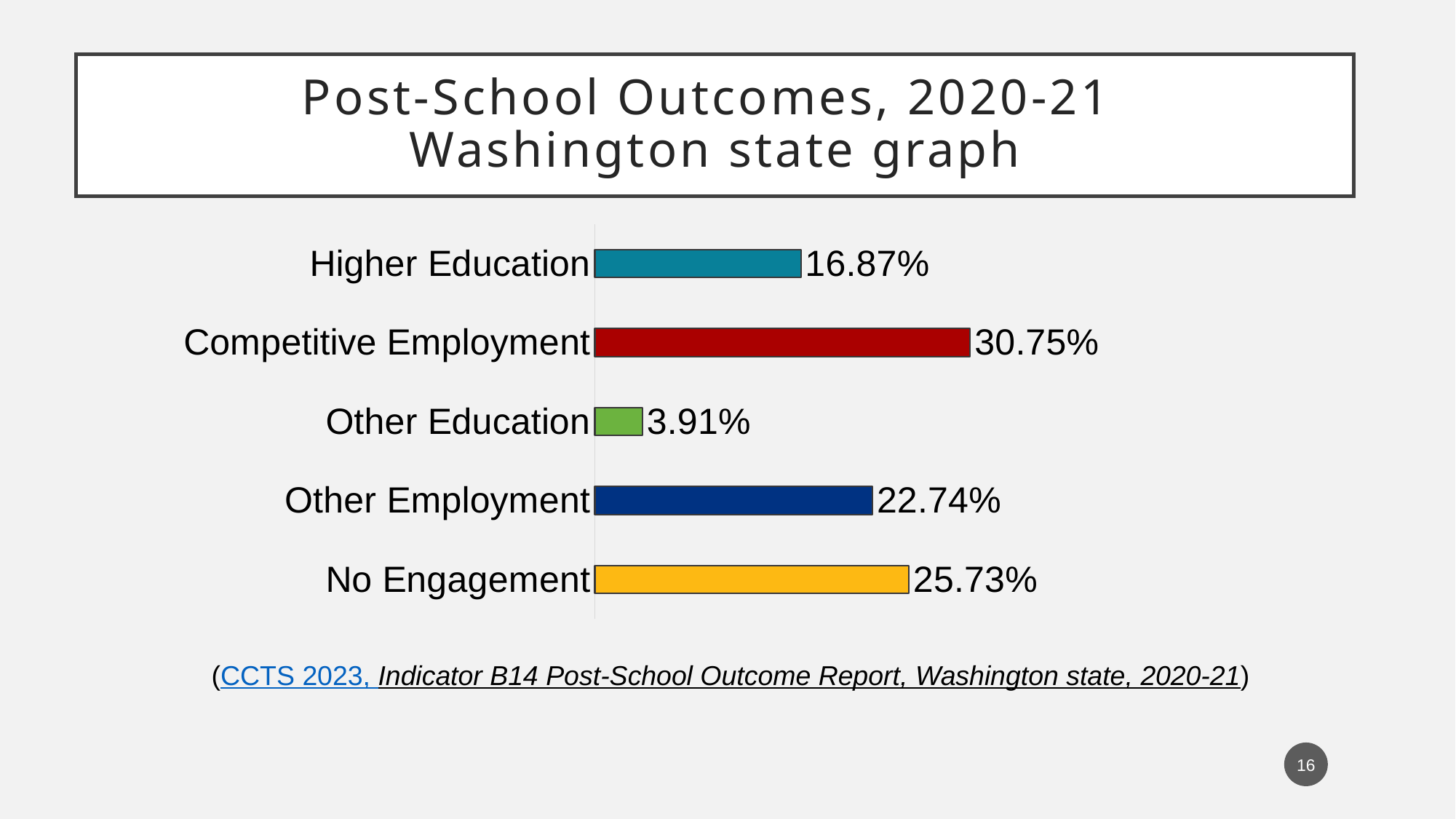
What is the value for Other Education? 3.91% What kind of chart is shown on the slide? Bar chart Which category has the highest value? Competitive Employment What is the value for No Engagement? 25.73% What colour is the bar for Competitive Employment? Red How many categories are shown in the chart? 5 What is the value for Competitive Employment? 30.75% What is the value for Higher Education? 16.87% Which category has the lowest value? Other Education What is the difference between Competitive Employment and Other Employment? 8.01% Which is larger, No Engagement or Other Employment? No Engagement What is the difference between No Engagement and Higher Education? 8.86%